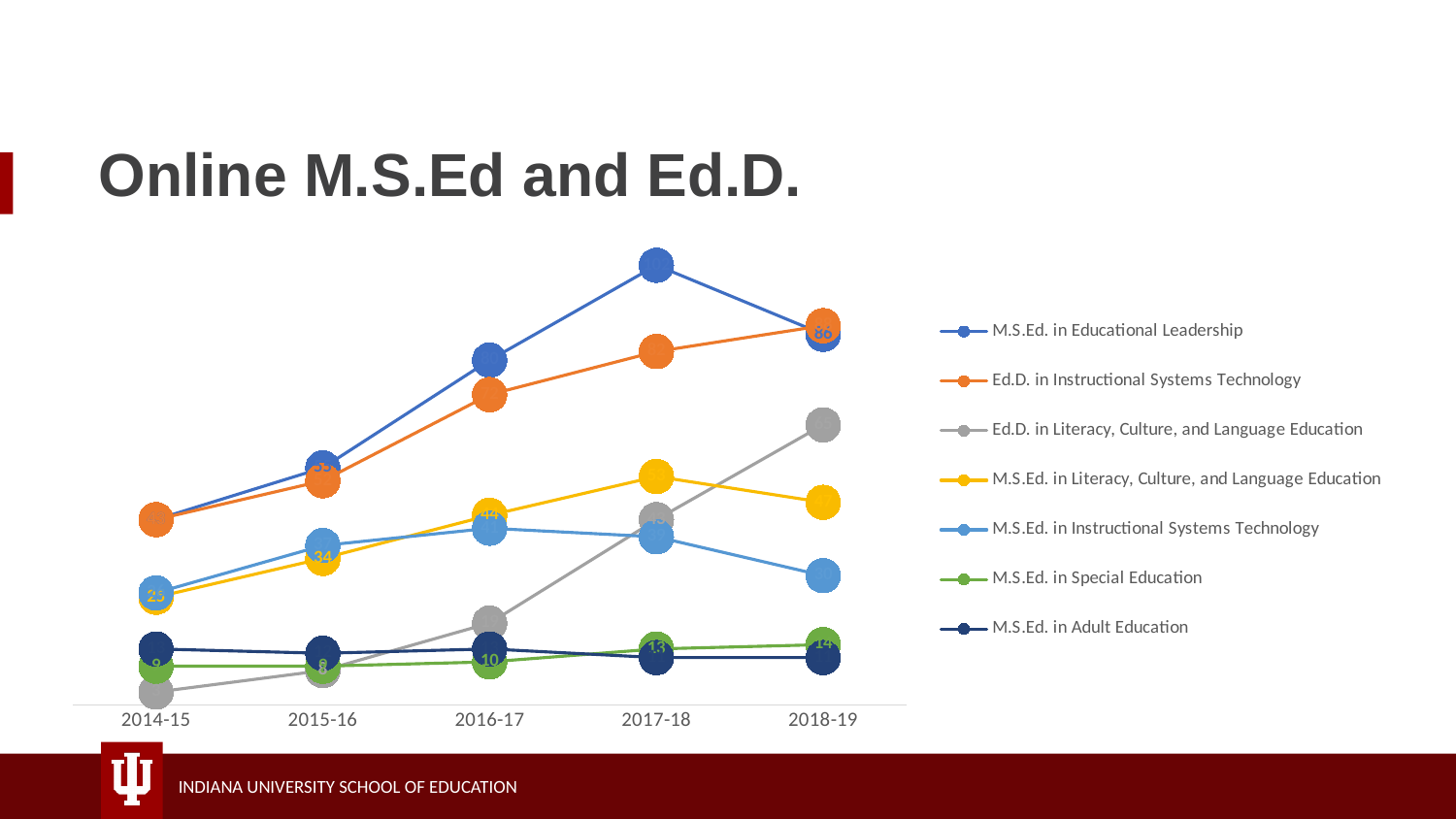
Which series has the lowest value in 2014-15? Ed.D. in Literacy, Culture, and Language Education What is the value for M.S.Ed. in Special Education in 2014-15? 9 How many academic years are shown on the x axis? 5 What is the value for M.S.Ed. in Special Education in 2018-19? 14 What kind of chart is shown on the slide? line chart How many series does the legend list? 7 In 2018-19, which is larger: Ed.D. in Literacy, Culture, and Language Education or M.S.Ed. in Literacy, Culture, and Language Education? Ed.D. in Literacy, Culture, and Language Education Which series has the highest value in 2017-18? M.S.Ed. in Educational Leadership Does the Ed.D. in Instructional Systems Technology series rise or fall from 2014-15 to 2018-19? rise Does the Ed.D. in Literacy, Culture, and Language Education series rise or fall from 2014-15 to 2018-19? rise By how much did M.S.Ed. in Special Education increase from 2014-15 to 2018-19? 5